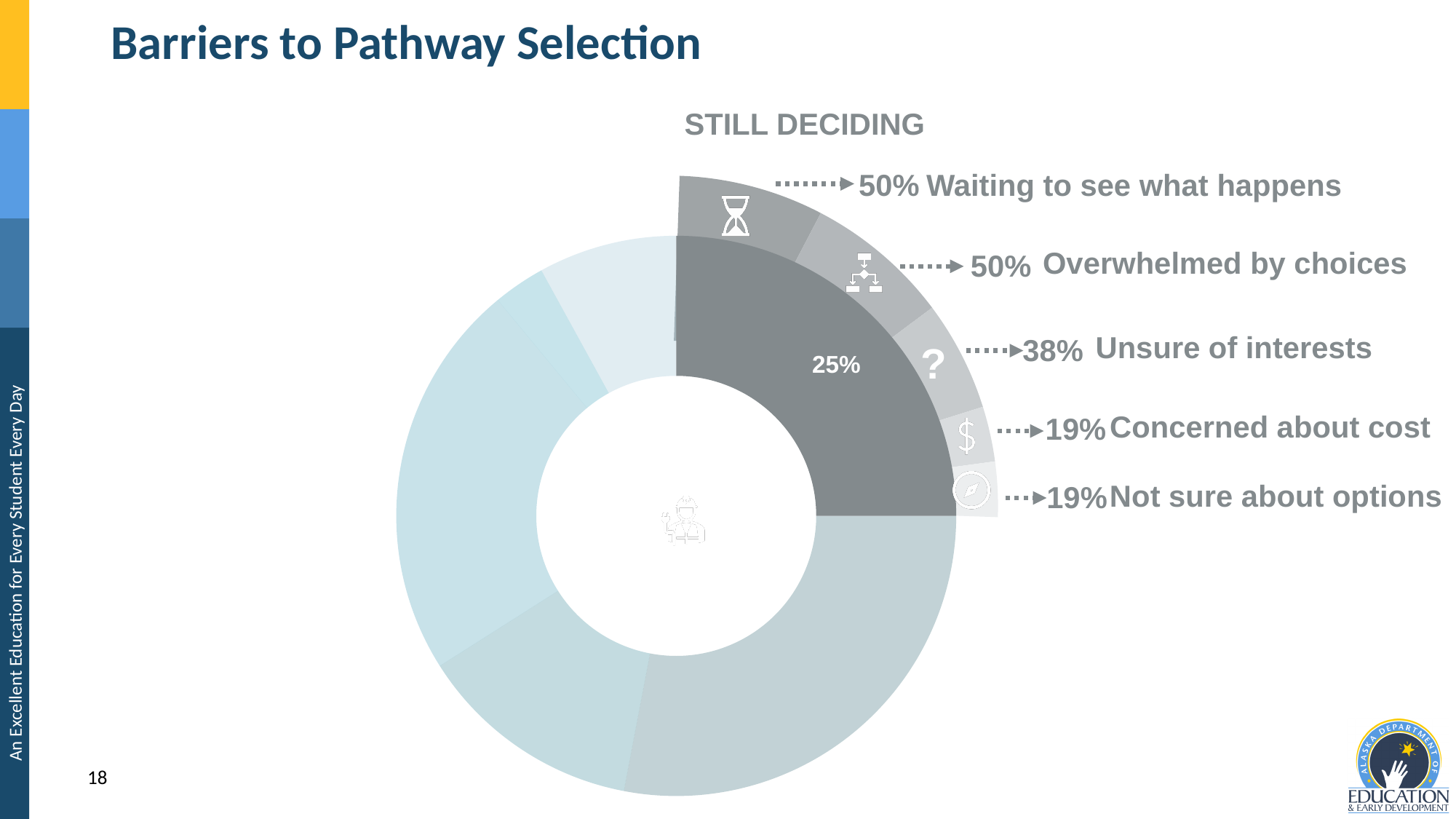
How many barriers are listed for the 'Still Deciding' group? 5 Which barrier has a larger percentage: 'Overwhelmed by choices' or 'Unsure of interests'? Overwhelmed by choices What percentage of students still deciding cited 'Waiting to see what happens' as a barrier? 50% What is the difference in percentage points between 'Unsure of interests' and 'Concerned about cost'? 19 What percentage is shown for 'Concerned about cost'? 19% What percentage of the donut chart is labeled for the 'Still Deciding' segment? 25% What kind of chart is shown on the slide? donut chart What percentage is shown for 'Not sure about options'? 19% What is the highest percentage listed among the barriers for students still deciding? 50% What percentage is shown for 'Unsure of interests'? 38% What percentage is shown for 'Overwhelmed by choices'? 50% What is the lowest percentage listed among the barriers for students still deciding? 19%